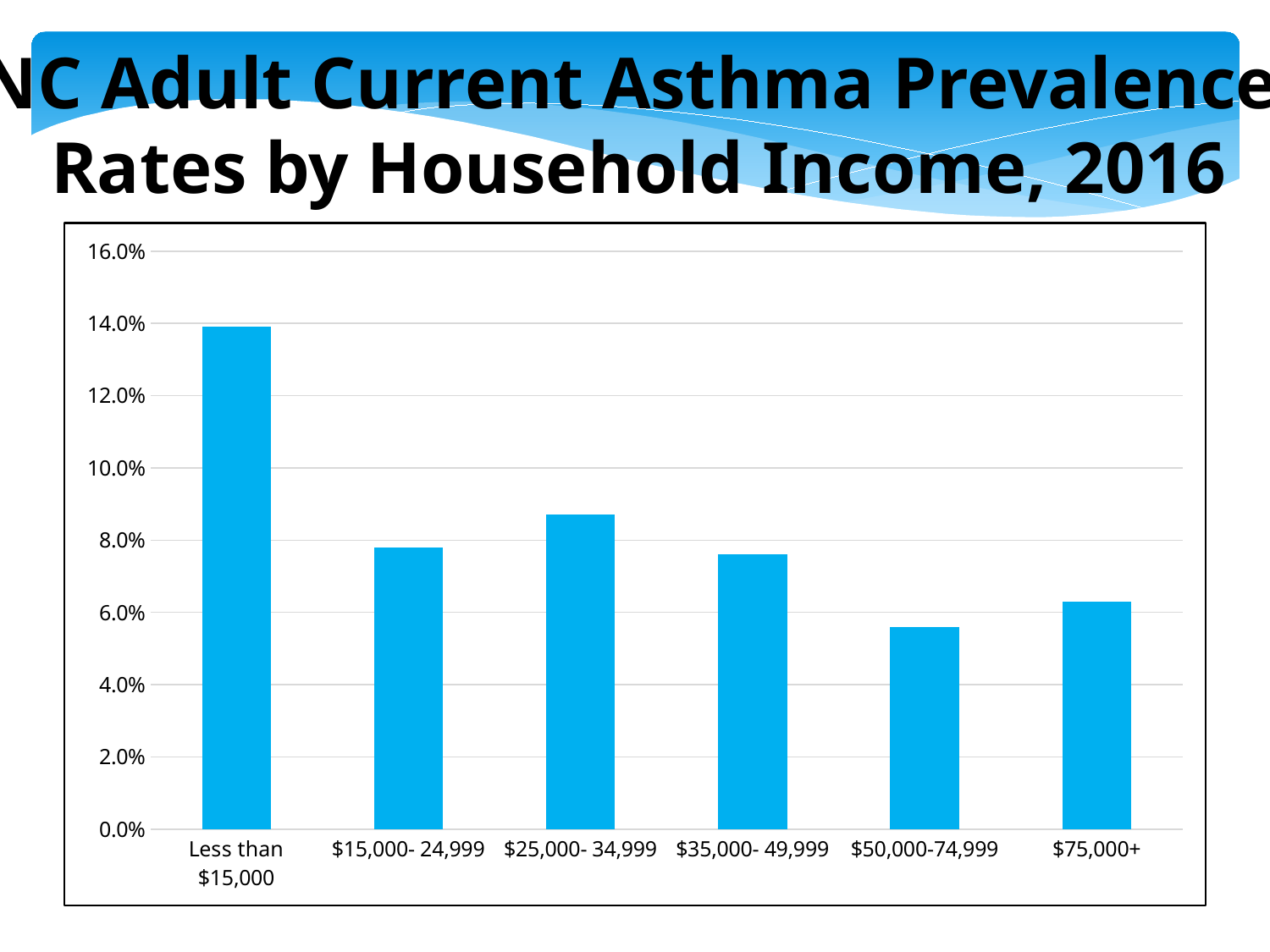
Which household income category has the highest asthma prevalence rate? Less than $15,000 Which is larger, the value for $25,000- 34,999 or the value for $15,000- 24,999? $25,000- 34,999 Is the value for $75,000+ greater or less than 6.0%? greater Which is larger, the value for $50,000-74,999 or the value for $75,000+? $75,000+ Is the value for Less than $15,000 greater or less than 12.0%? greater Which household income category has the lowest asthma prevalence rate? $50,000-74,999 Is the value for $25,000- 34,999 greater or less than 8.0%? greater What is the title of the slide containing the chart? NC Adult Current Asthma Prevalence Rates by Household Income, 2016 What kind of chart is shown on the slide? bar chart How many household income categories are shown on the x axis? 6